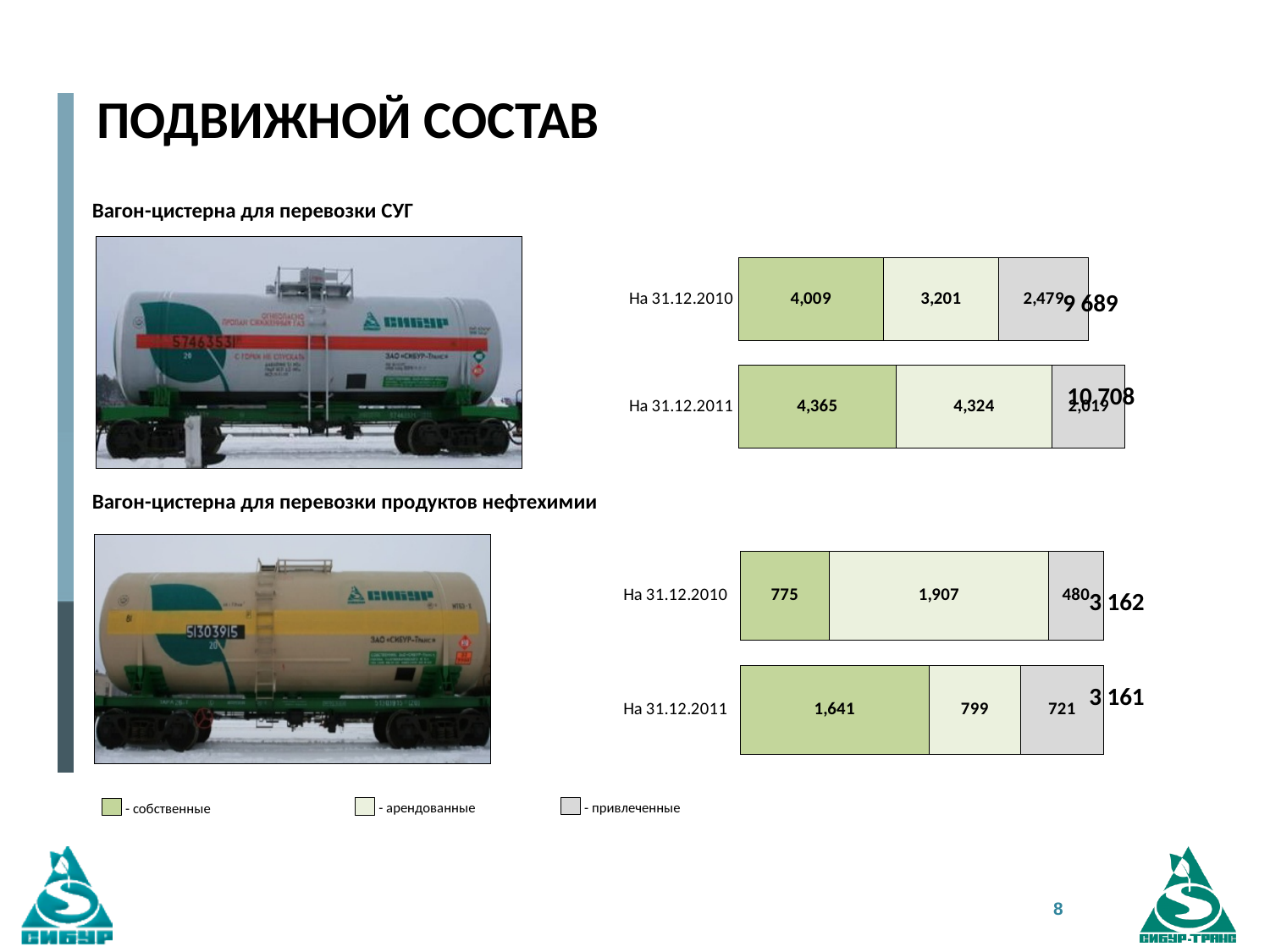
In the chart for Вагон-цистерна для перевозки СУГ, which is larger: собственные on 31.12.2010 or собственные on 31.12.2011? собственные on 31.12.2011 In the chart for Вагон-цистерна для перевозки продуктов нефтехимии, what is the value of арендованные on 31.12.2010? 1,907 What kind of chart is used for the Вагон-цистерна для перевозки СУГ data? Stacked bar chart In the chart for Вагон-цистерна для перевозки продуктов нефтехимии, which segment is largest in the bar На 31.12.2011? собственные In the chart for Вагон-цистерна для перевозки продуктов нефтехимии, what is the total shown for the bar На 31.12.2010? 3 162 In the chart for Вагон-цистерна для перевозки продуктов нефтехимии, by how much did собственные increase from 31.12.2010 to 31.12.2011? 866 In the chart for Вагон-цистерна для перевозки СУГ, what is the value of привлеченные on 31.12.2010? 2,479 In the chart for Вагон-цистерна для перевозки продуктов нефтехимии, what is the value of собственные on 31.12.2011? 1,641 In the chart for Вагон-цистерна для перевозки СУГ, what is the value of собственные on 31.12.2010? 4,009 In the chart for Вагон-цистерна для перевозки СУГ, what is the total shown for the bar На 31.12.2011? 10 708 How many series does the legend at the bottom of the slide list? 3 In the chart for Вагон-цистерна для перевозки СУГ, what is the value of арендованные on 31.12.2011? 4,324